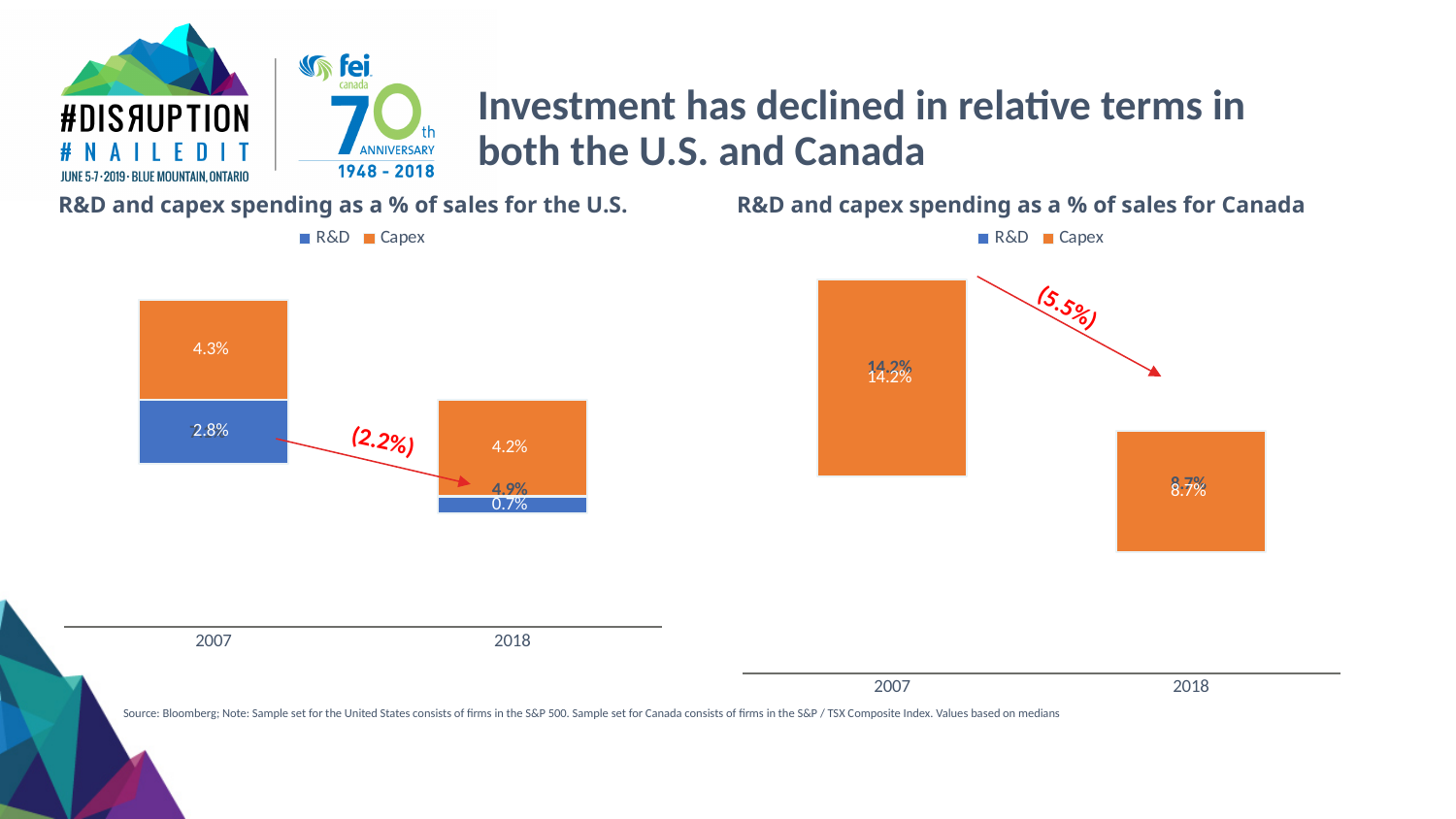
In the U.S. chart, what is the R&D value for 2007? 2.8% In the U.S. chart, what is the total of the stacked bar for 2018? 4.9% In the U.S. chart, what is the R&D value for 2018? 0.7% In the U.S. chart, what is the Capex value for 2007? 4.3% In the U.S. chart, what is the total of the stacked bar for 2007? 7.1% In the Canada chart, what is the difference between the 2007 and 2018 Capex values? 5.5% In the Canada chart, what is the Capex value for 2018? 8.7% In the Canada chart, what is the Capex value for 2007? 14.2% How many series does the legend of the U.S. chart list? 2 What kind of chart is the Canada chart? bar chart In the Canada chart, do the Capex values rise or fall from 2007 to 2018? fall In the U.S. chart, which year has the higher R&D value, 2007 or 2018? 2007